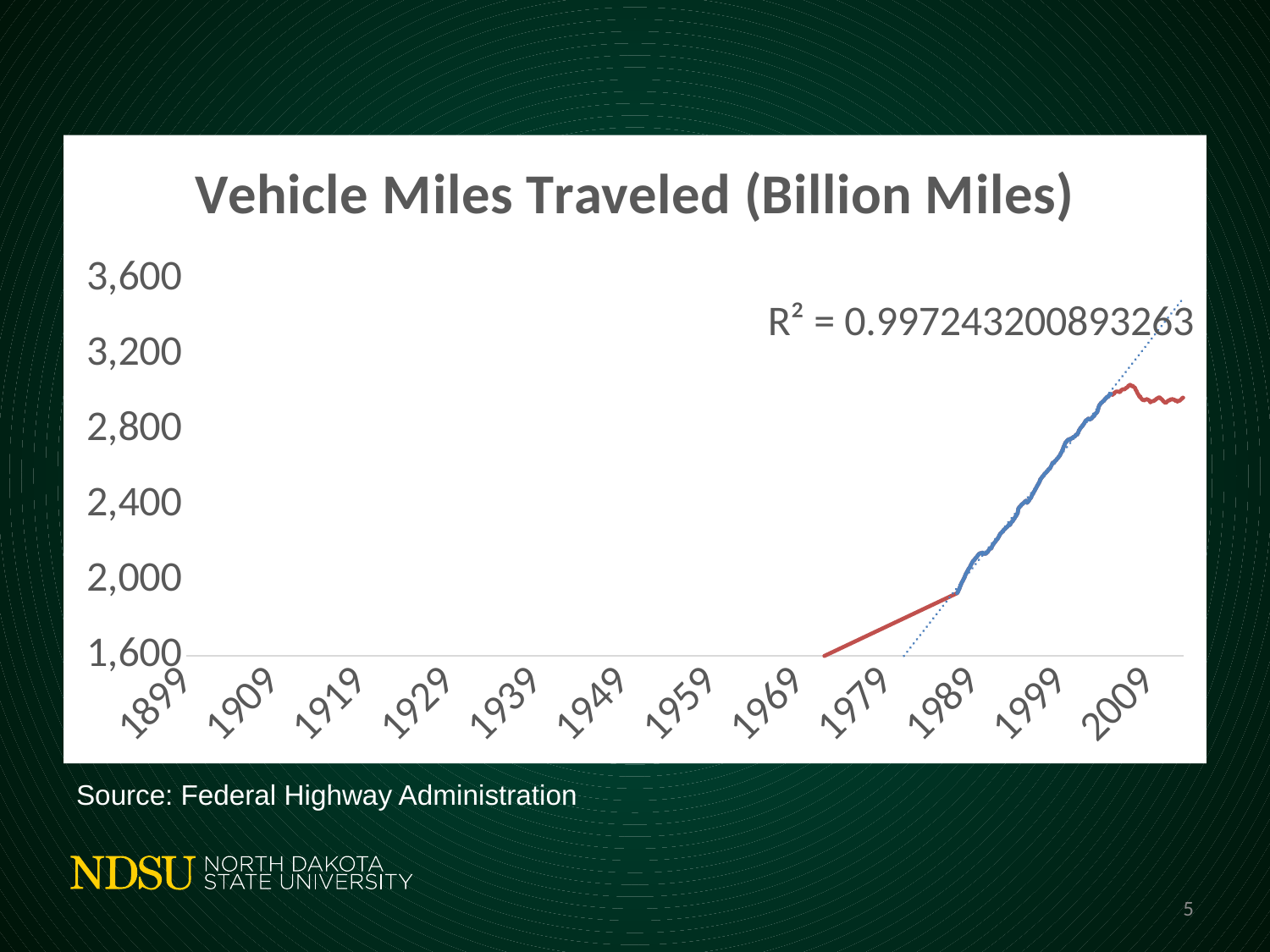
Is the value for 1999 greater or less than 2,400? greater Is the value for 2009 greater or less than 3,200? less Do the plotted vehicle miles traveled generally rise or fall from 1969 to 2009? Rise Which year has the larger value, 1989 or 2009? 2009 What is the title of the chart? Vehicle Miles Traveled (Billion Miles) Is the value for 2009 greater or less than 2,800? greater How many year labels are shown on the x axis? 12 What kind of chart is shown on the slide? Line chart What R² value is printed on the chart? R² = 0.997243200893263